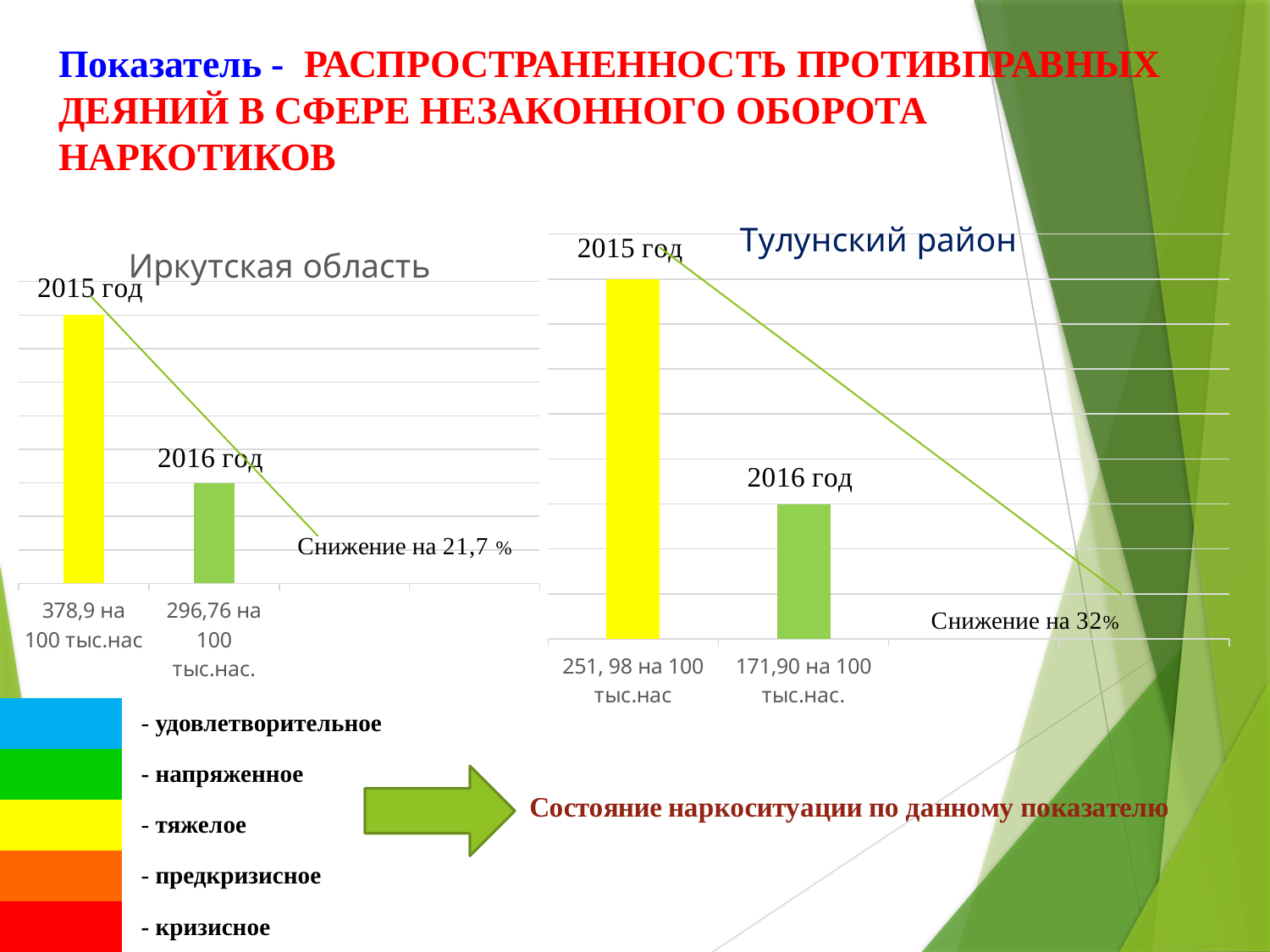
In the chart titled "Иркутская область", which year has the higher bar? 2015 год In the chart titled "Тулунский район", is the value for 2015 год larger or smaller than the value for 2016 год? larger In the chart titled "Иркутская область", what is the difference between the 2015 and 2016 values? 82,14 What kind of chart is the chart titled "Иркутская область"? bar chart In the chart titled "Иркутская область", what is the value for 2015 год? 378,9 на 100 тыс.нас In the chart titled "Тулунский район", what is the value for 2015 год? 251, 98 на 100 тыс.нас How many bars are shown in the chart titled "Иркутская область"? 2 In the chart titled "Иркутская область", what is the value for 2016 год? 296,76 на 100 тыс.нас. In the chart titled "Тулунский район", what is the value for 2016 год? 171,90 на 100 тыс.нас. In the chart titled "Тулунский район", which year has the lower bar? 2016 год In the chart titled "Тулунский район", what is the difference between the 2015 and 2016 values? 80,08 In the chart titled "Тулунский район", do the values rise or fall from 2015 to 2016? fall